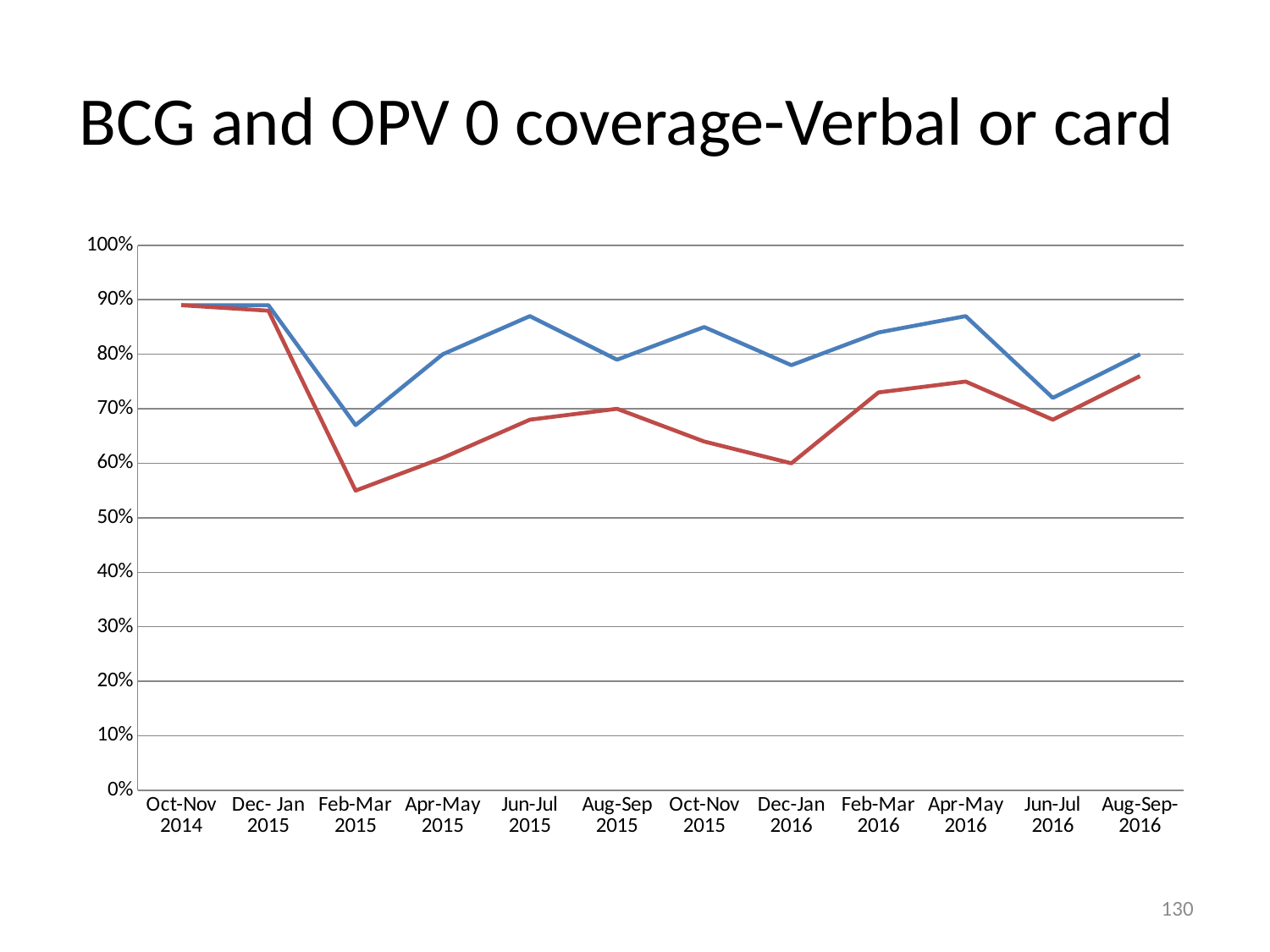
How many time periods are plotted along the x axis? 12 Does the red line rise or fall from Feb-Mar 2015 to Aug-Sep 2015? rise What is the title of the chart on the slide? BCG and OPV 0 coverage-Verbal or card How many lines are plotted on the chart? 2 In which period does the red line reach its lowest value? Feb-Mar 2015 Is the value of the blue line for Jun-Jul 2015 greater or less than 80%? greater Is the value of the red line for Feb-Mar 2015 greater or less than 60%? less Is the value of the red line for Apr-May 2016 greater or less than 70%? greater For Feb-Mar 2015, which line has the higher value, the blue line or the red line? blue line In which period does the blue line reach its lowest value? Feb-Mar 2015 What kind of chart is shown on the slide? line chart